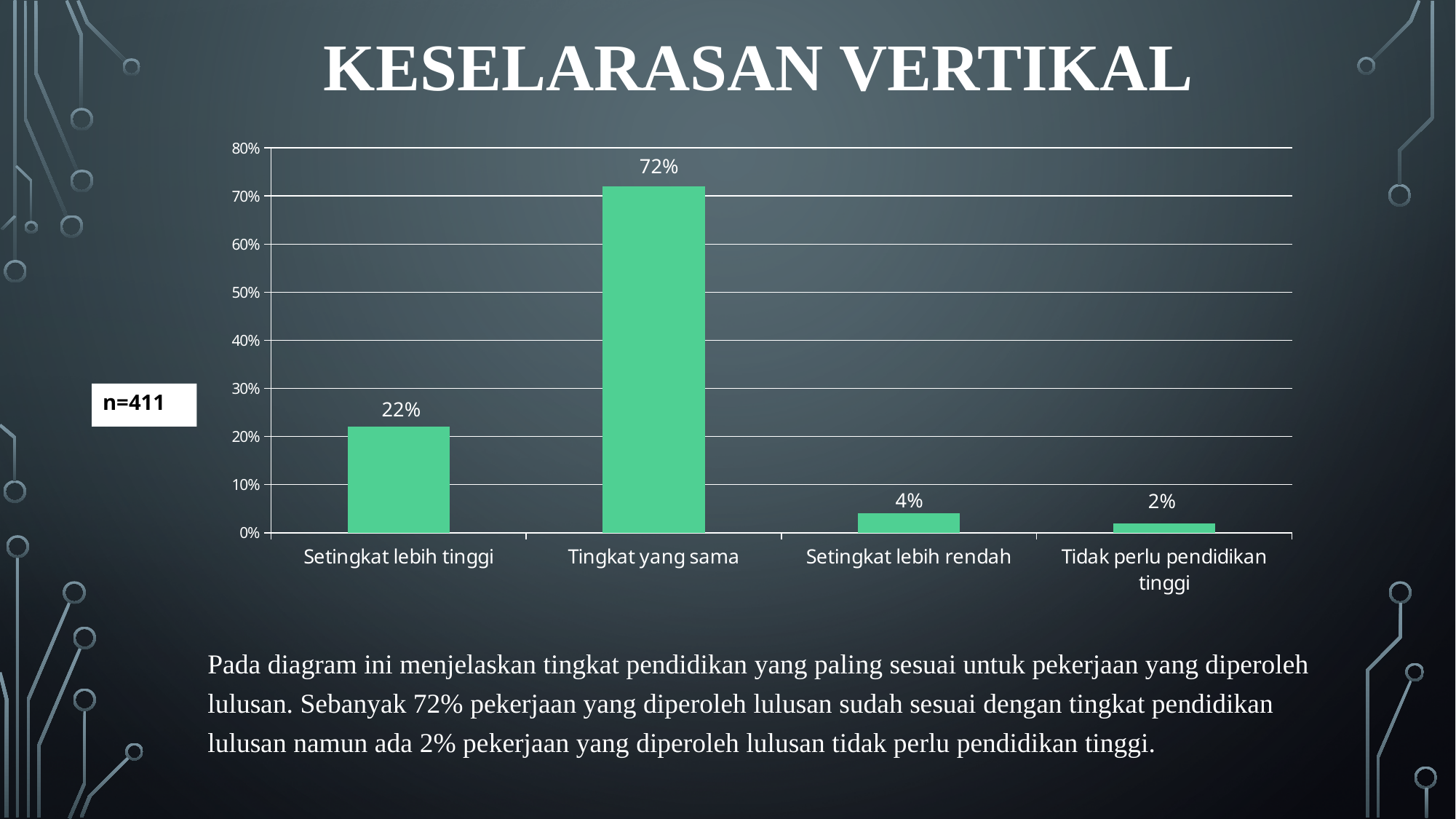
What is the value for "Setingkat lebih tinggi"? 22% Is the value for "Setingkat lebih tinggi" greater or less than 30%? less How many categories are shown on the x axis? 4 Which is larger, the value for "Setingkat lebih rendah" or the value for "Tidak perlu pendidikan tinggi"? Setingkat lebih rendah Which category has the lowest value? Tidak perlu pendidikan tinggi What is the sample size (n) shown next to the chart? n=411 What kind of chart is shown on the slide? bar chart What is the value for "Tingkat yang sama"? 72% What is the value for "Tidak perlu pendidikan tinggi"? 2% What is the difference between the values for "Tingkat yang sama" and "Setingkat lebih tinggi"? 50% Which category has the highest value? Tingkat yang sama What is the value for "Setingkat lebih rendah"? 4%